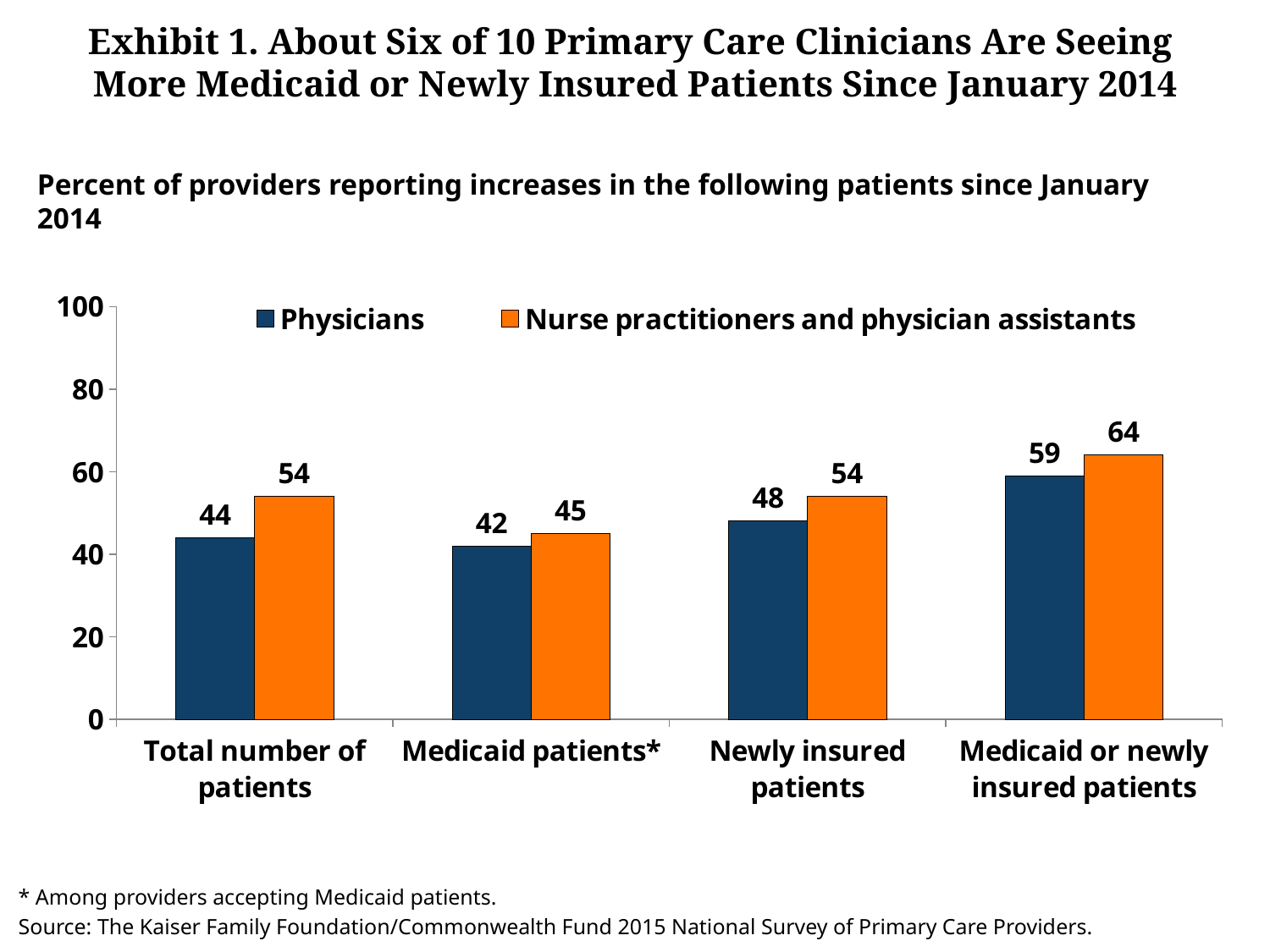
What is the difference between nurse practitioners and physician assistants and physicians for newly insured patients? 6 For the total number of patients, which series has the larger value, physicians or nurse practitioners and physician assistants? Nurse practitioners and physician assistants What percent of physicians reported an increase in the total number of patients? 44 What colour represents physicians in the chart? Dark blue Is the value for physicians for Medicaid or newly insured patients greater or less than 40? greater What kind of chart is shown on the slide? Bar chart Which category has the lowest value for nurse practitioners and physician assistants? Medicaid patients* How many categories are shown on the x axis? 4 What value is shown for physicians for Medicaid patients? 42 How many series does the legend list? 2 What value is shown for nurse practitioners and physician assistants for Medicaid or newly insured patients? 64 Which category has the highest value for physicians? Medicaid or newly insured patients